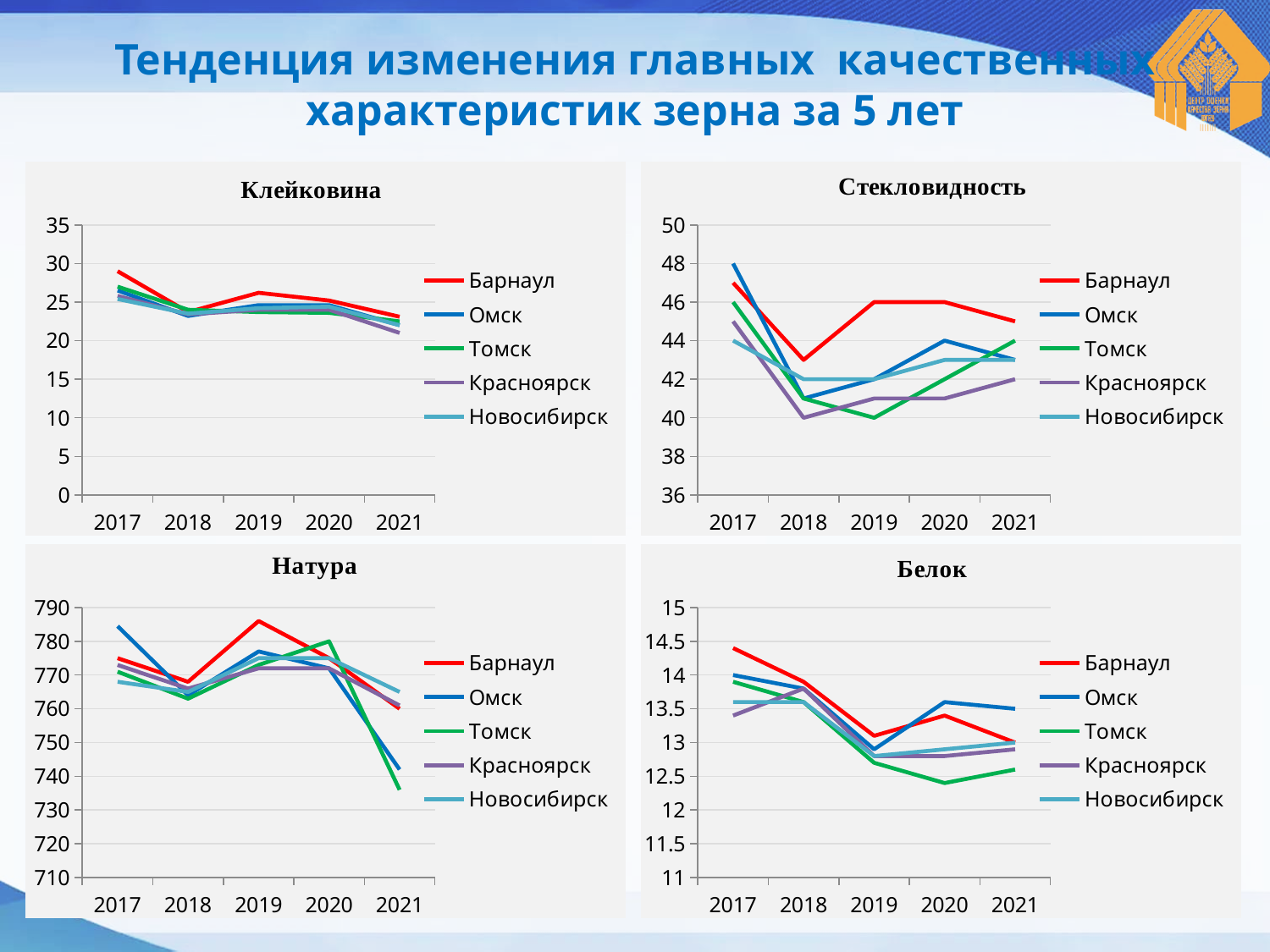
In the "Стекловидность" chart, what is the value for Омск in 2017? 48 How many years are shown on the x axis of the "Натура" chart? 5 In the "Стекловидность" chart, what is the value for Барнаул in 2020? 46 In the "Натура" chart, which series has the lowest value in 2021? Томск What kind of chart is the "Клейковина" chart? line chart In the "Стекловидность" chart, what is the difference between Барнаул and Омск in 2020? 2 In the "Белок" chart, which is larger in 2020: Омск or Томск? Омск In the "Клейковина" chart, which series has the highest value in 2017? Барнаул In the "Стекловидность" chart, which series has the highest value in 2017? Омск In the "Белок" chart, does the Барнаул line rise or fall from 2017 to 2019? fall In the "Натура" chart, is the value for Барнаул in 2019 greater or less than 780? greater How many series does the legend of the "Стекловидность" chart list? 5